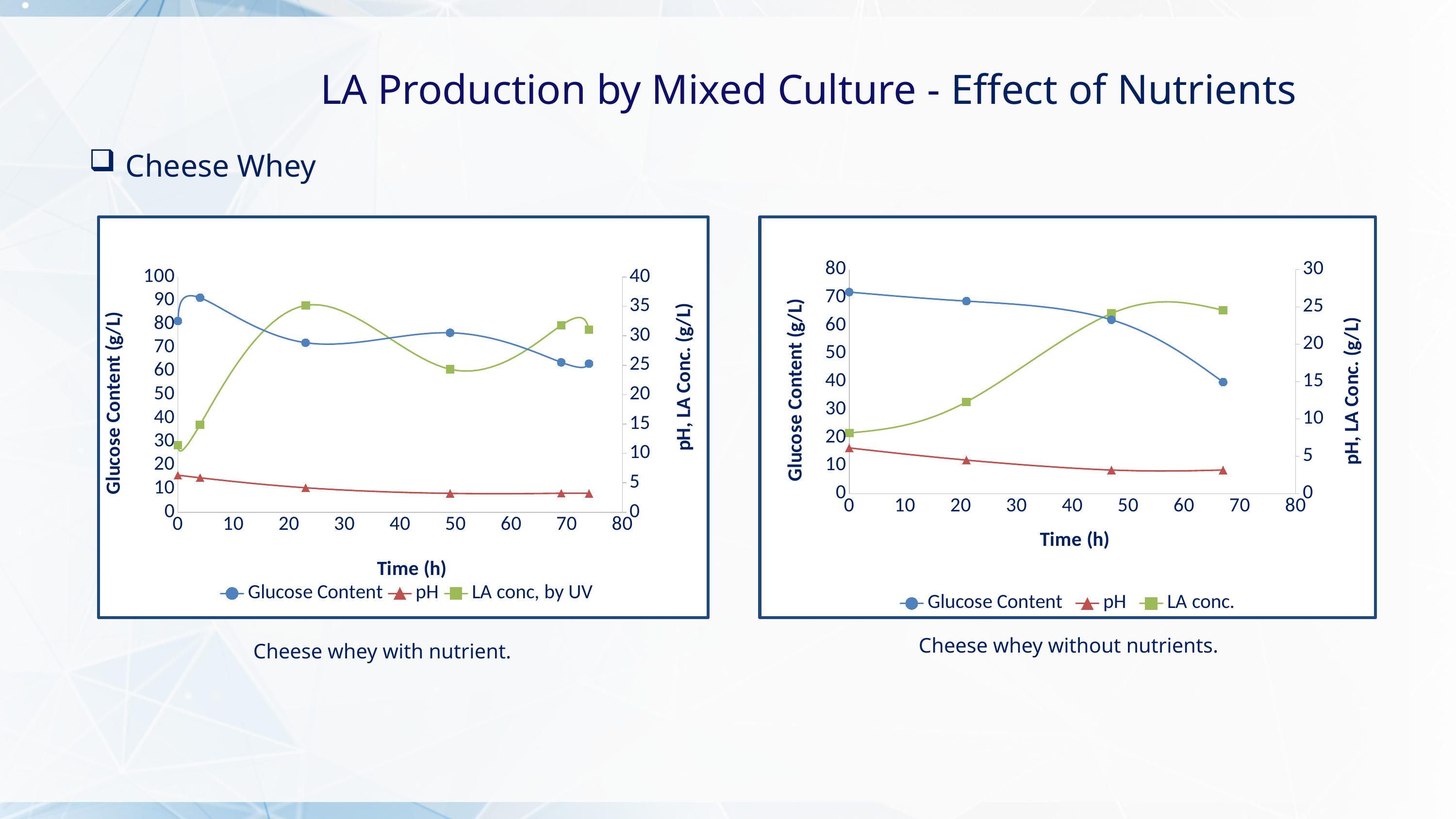
In the right chart (Cheese whey without nutrients), how many data points are plotted for the Glucose Content series? 4 What kind of chart is the left chart, captioned "Cheese whey with nutrient."? line chart In the right chart (Cheese whey without nutrients), does the LA conc. series rise or fall from 0 h to 47 h? rise In the right chart (Cheese whey without nutrients), does the Glucose Content series rise or fall over time? fall In the left chart (Cheese whey with nutrient), which series has the lowest values on the secondary axis at the end of the run? pH How many series does the legend of the right chart, captioned "Cheese whey without nutrients.", list? 3 In the right chart (Cheese whey without nutrients), is the Glucose Content value at the last time point (about 67 h) greater or less than 50 g/L? less In the left chart (Cheese whey with nutrient), how many data points are plotted for the pH series? 6 In the left chart (Cheese whey with nutrient), is the Glucose Content value at 0 h greater or less than 70 g/L? greater What is the x-axis title of the left chart (Cheese whey with nutrient)? Time (h) In the right chart (Cheese whey without nutrients), is the Glucose Content at 0 h larger or smaller than at 67 h? larger